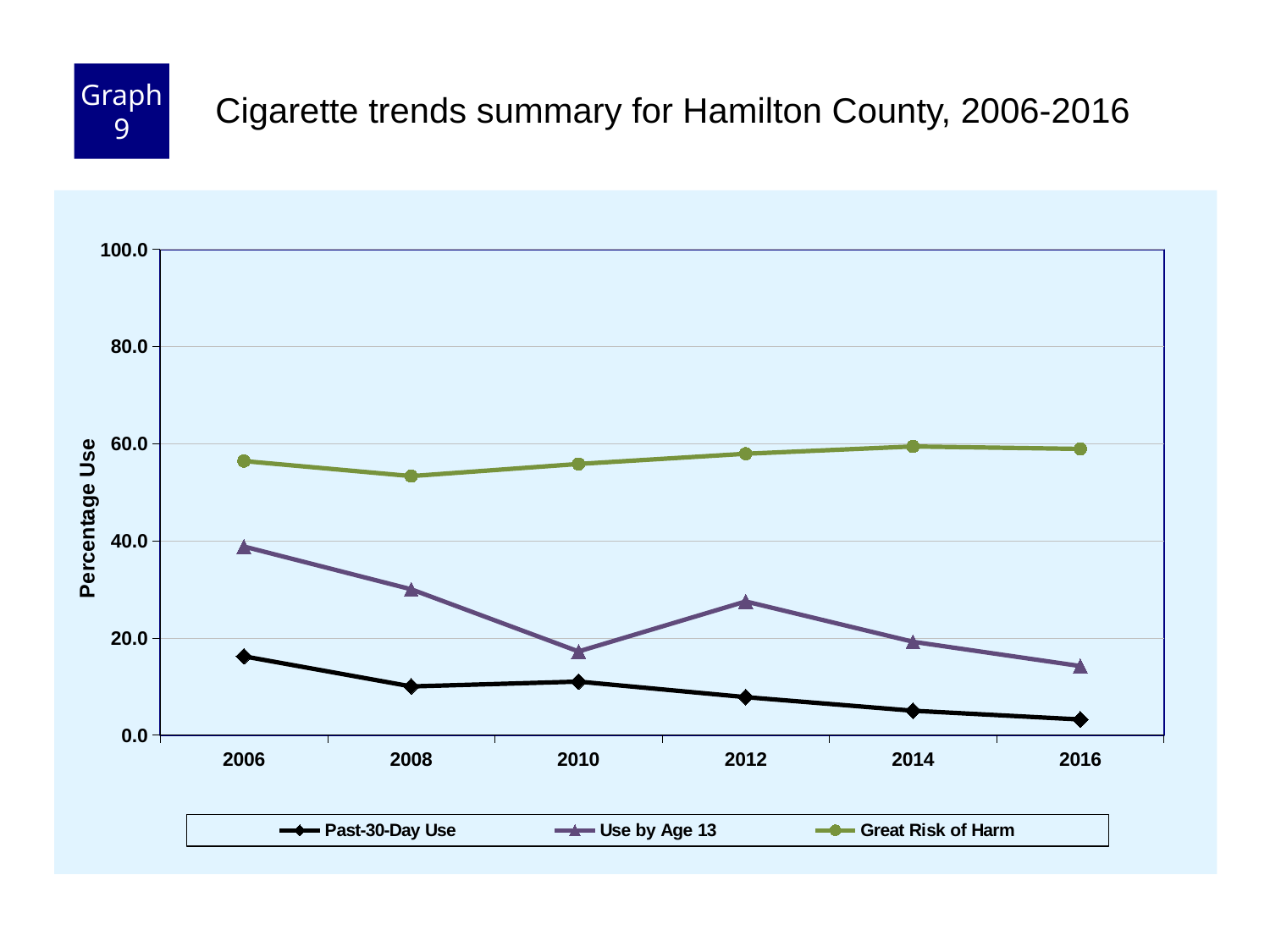
What kind of chart is shown on the slide? Line chart In which year is Use by Age 13 highest? 2006 In which year is Past-30-Day Use lowest? 2016 In which year is Great Risk of Harm lowest? 2008 Is the value for Great Risk of Harm in 2008 greater or less than 60.0? less What is the label on the y axis? Percentage Use How many years are plotted along the x axis? 6 Is the value for Past-30-Day Use in 2006 greater or less than 20.0? less Does Past-30-Day Use generally rise or fall from 2006 to 2016? Fall Which is larger for Use by Age 13: the value in 2010 or the value in 2012? 2012 How many series does the legend list? 3 Is the value for Use by Age 13 in 2006 greater or less than 20.0? greater